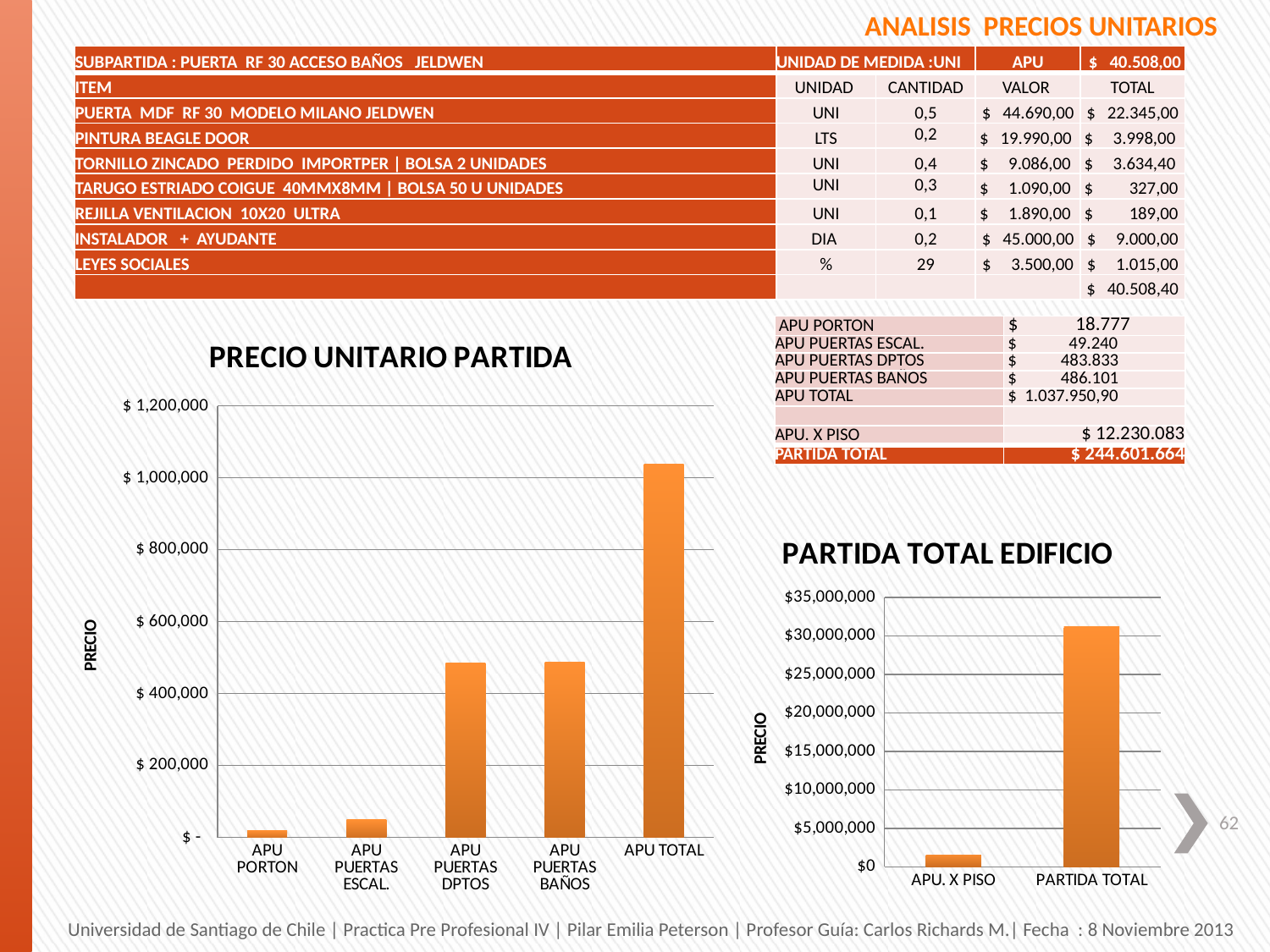
In the "PRECIO UNITARIO PARTIDA" chart, is the value for APU TOTAL greater or less than $800,000? greater What is the y-axis title of the "PRECIO UNITARIO PARTIDA" chart? PRECIO In the "PARTIDA TOTAL EDIFICIO" chart, how many bars are shown? 2 What kind of chart is the "PRECIO UNITARIO PARTIDA" chart? bar chart In the "PRECIO UNITARIO PARTIDA" chart, which is larger, APU PUERTAS ESCAL. or APU PUERTAS DPTOS? APU PUERTAS DPTOS In the "PARTIDA TOTAL EDIFICIO" chart, which category has the higher value? PARTIDA TOTAL In the "PARTIDA TOTAL EDIFICIO" chart, is the value for APU. X PISO greater or less than $5,000,000? less In the "PRECIO UNITARIO PARTIDA" chart, which category has the highest value? APU TOTAL In the "PRECIO UNITARIO PARTIDA" chart, is the value for APU PUERTAS DPTOS greater or less than $600,000? less In the "PRECIO UNITARIO PARTIDA" chart, which category has the lowest value? APU PORTON In the "PRECIO UNITARIO PARTIDA" chart, how many categories are shown on the x axis? 5